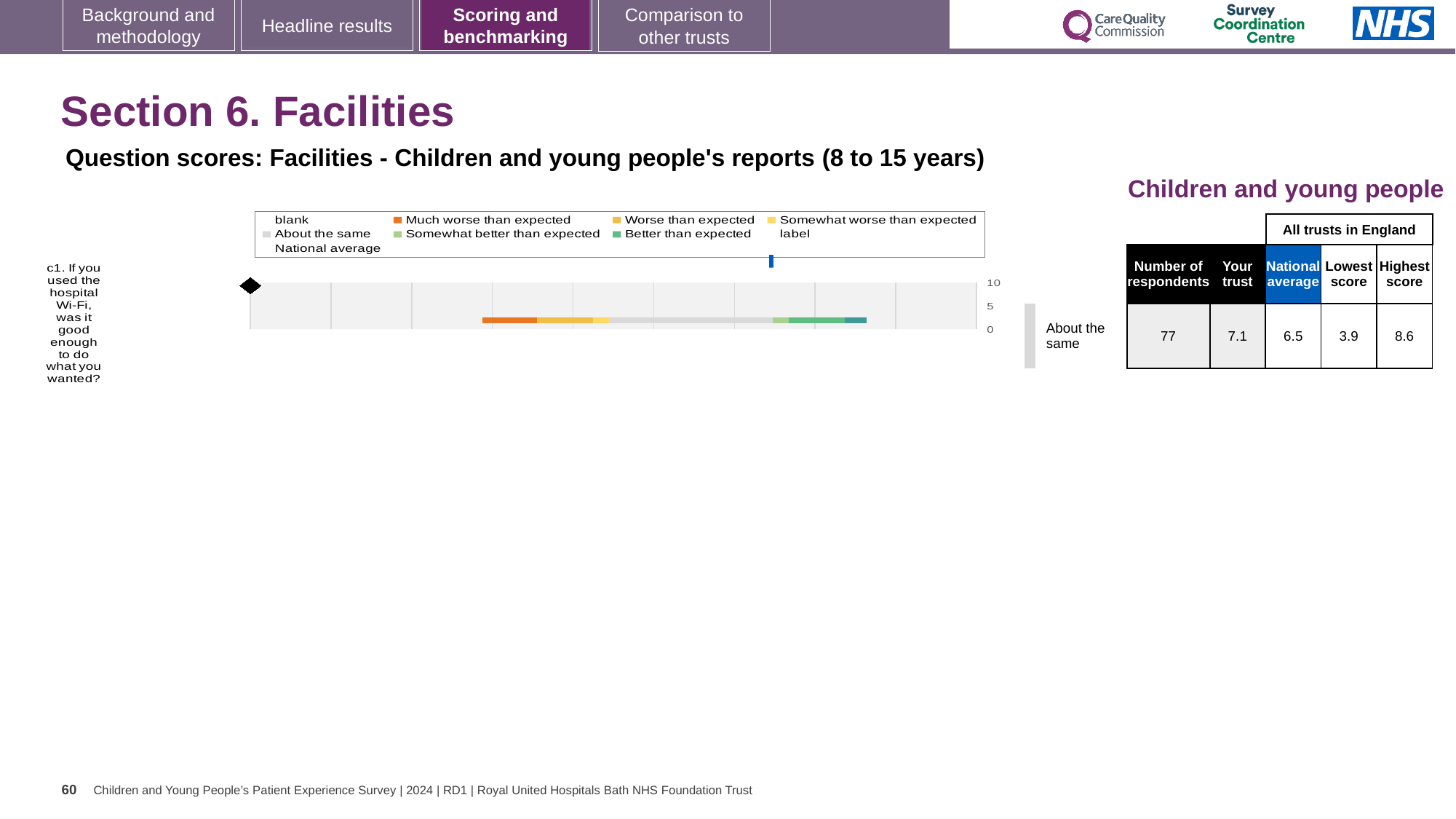
Which is larger for question c1: the trust's score or the national average? the trust's score Which legend entry is shown in orange? Much worse than expected What is the highest score among all trusts in England for question c1? 8.6 What is the national average score for question c1? 6.5 How many survey questions (categories) are plotted in the chart? 1 Which survey question is plotted in the chart? c1. If you used the hospital Wi-Fi, was it good enough to do what you wanted? What is the lowest score among all trusts in England for question c1? 3.9 What kind of chart is shown on the slide? bar chart What is the trust's score for question c1 according to the table? 7.1 What is the difference between the highest and lowest scores for question c1? 4.7 What benchmarking category is the trust's score for question c1 placed in? About the same How many respondents answered question c1? 77